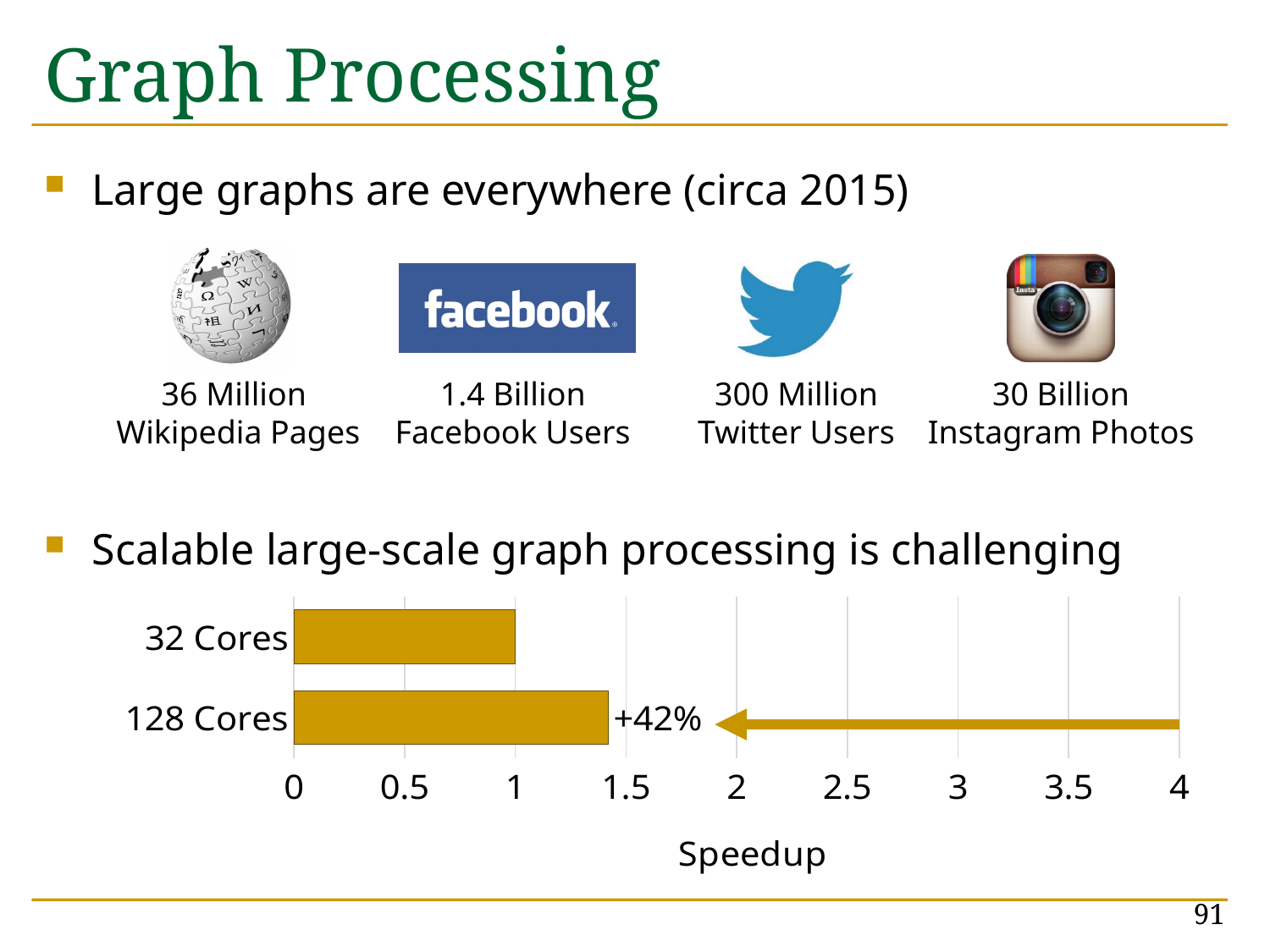
Is the speedup for 128 Cores greater or less than 1? greater How many categories does the bar chart show? 2 Is the speedup for 128 Cores greater or less than 1.5? less What is the maximum value shown on the x axis of the bar chart? 4 What kind of chart is shown on the slide? bar chart Which category has the higher speedup, 32 Cores or 128 Cores? 128 Cores What is the speedup value for 32 Cores? 1 Which category has the lowest speedup? 32 Cores What is the label of the x axis of the bar chart? Speedup Is the speedup for 128 Cores greater or less than 2? less What annotation is printed next to the 128 Cores bar? +42% Which category has the highest speedup? 128 Cores